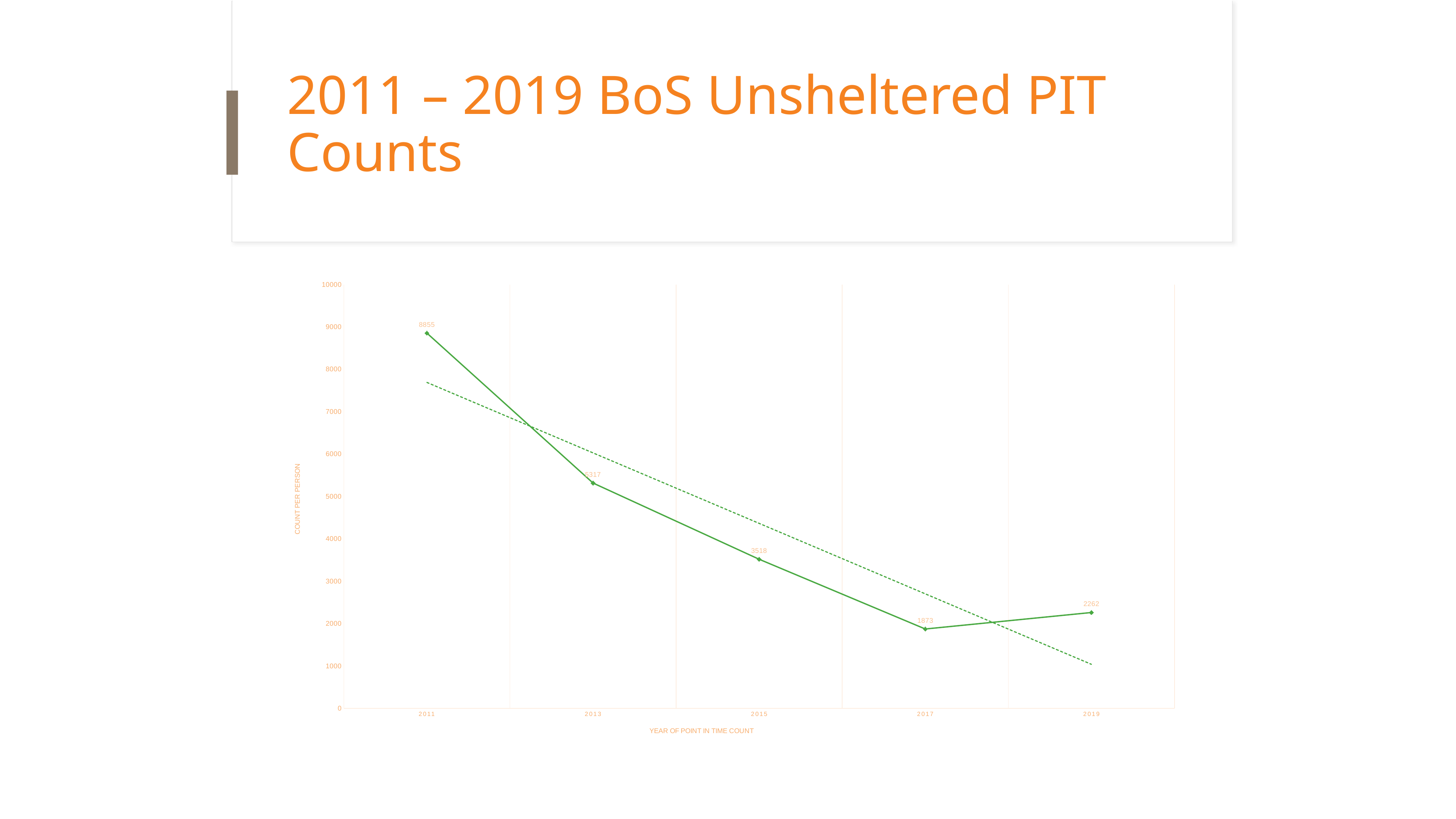
Which year had a larger count, 2017 or 2019? 2019 What is the difference between the 2011 count and the 2013 count? 3538 What kind of chart is shown on the slide? Line chart Which year had the lowest unsheltered PIT count? 2017 What was the unsheltered PIT count in 2011? 8855 What was the unsheltered PIT count in 2015? 3518 How many years are plotted on the x axis? 5 What is the label of the x axis? YEAR OF POINT IN TIME COUNT What was the unsheltered PIT count in 2013? 5317 What was the unsheltered PIT count in 2017? 1873 Which year had the highest unsheltered PIT count? 2011 What was the unsheltered PIT count in 2019? 2262